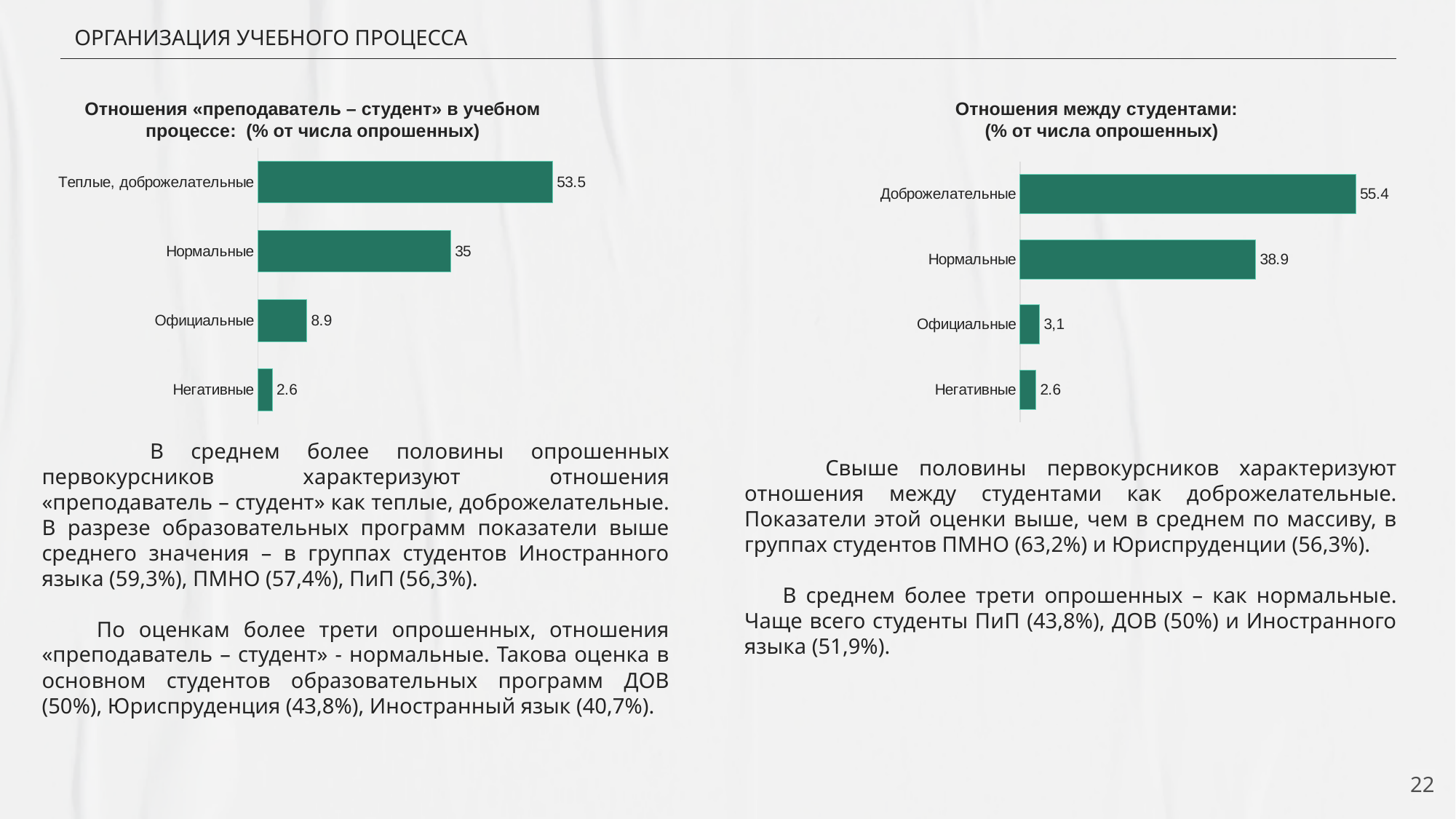
In the right chart (Отношения между студентами), what is the value for «Официальные»? 3,1 What type of chart is the left chart (Отношения «преподаватель – студент»)? Bar chart In the right chart (Отношения между студентами), what is the value for «Нормальные»? 38.9 What is the title of the right chart? Отношения между студентами: (% от числа опрошенных) Which is larger: «Нормальные» in the left chart or «Нормальные» in the right chart? Нормальные in the right chart (38.9) How many categories are shown in the right chart (Отношения между студентами)? 4 In the right chart (Отношения между студентами), which category has the lowest value? Негативные In the left chart (Отношения «преподаватель – студент»), what is the value for «Теплые, доброжелательные»? 53.5 In the left chart (Отношения «преподаватель – студент»), what is the value for «Официальные»? 8.9 In the left chart (Отношения «преподаватель – студент»), what is the difference between «Теплые, доброжелательные» and «Нормальные»? 18.5 In the right chart (Отношения между студентами), what is the difference between «Доброжелательные» and «Нормальные»? 16.5 In the left chart (Отношения «преподаватель – студент»), which category has the highest value? Теплые, доброжелательные